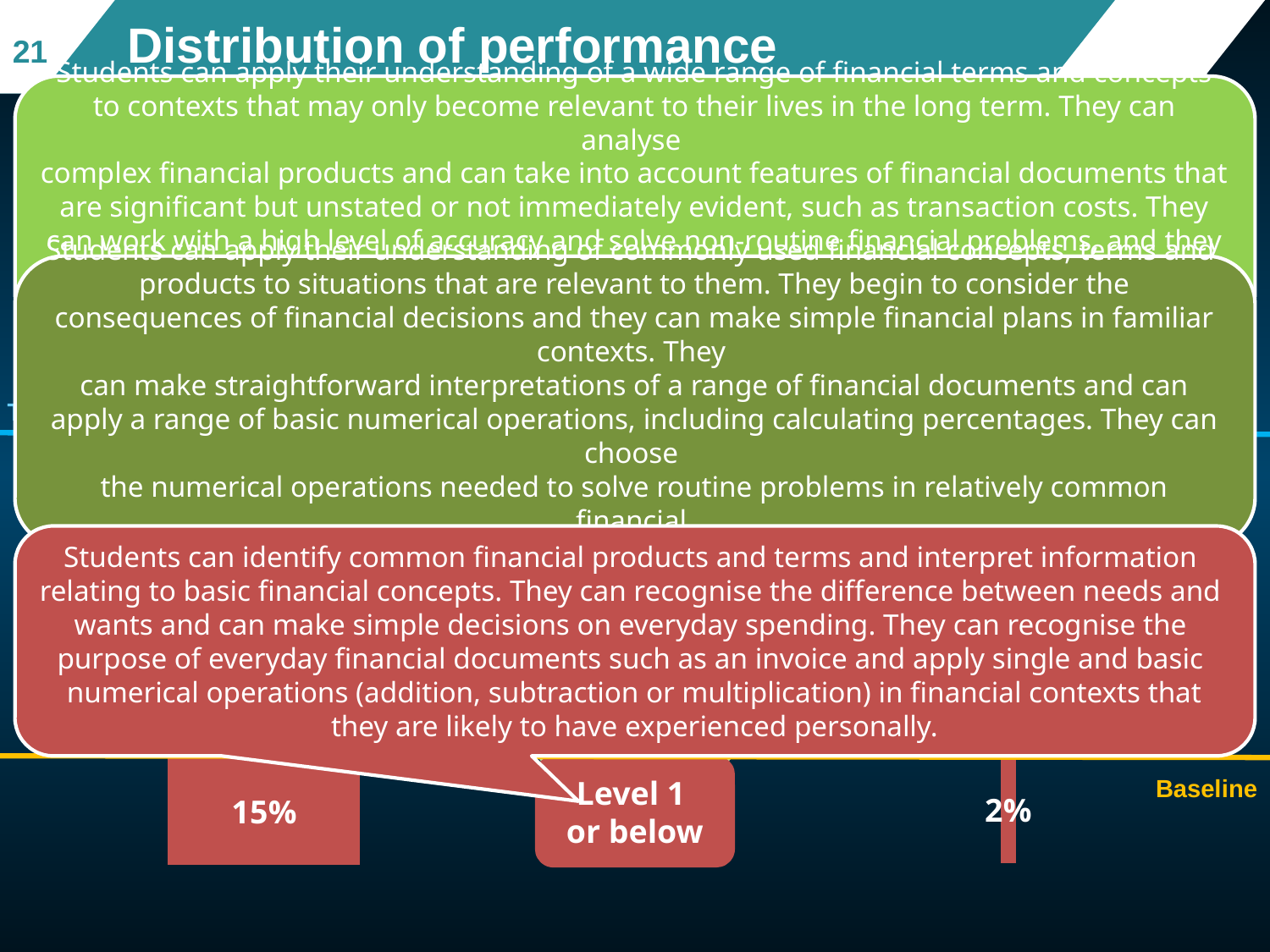
What performance level label is shown in the red box between the two red bars? Level 1 or below What value is printed on the red bar on the right side of the chart, near the 'Baseline' label? 2% What value is printed on the leftmost red bar at the bottom of the slide? 15% What is the difference between the two printed red bar values, 15% and 2%? 13% What kind of chart is shown at the bottom of the slide? bar chart What label appears in yellow text at the right edge of the chart area? Baseline